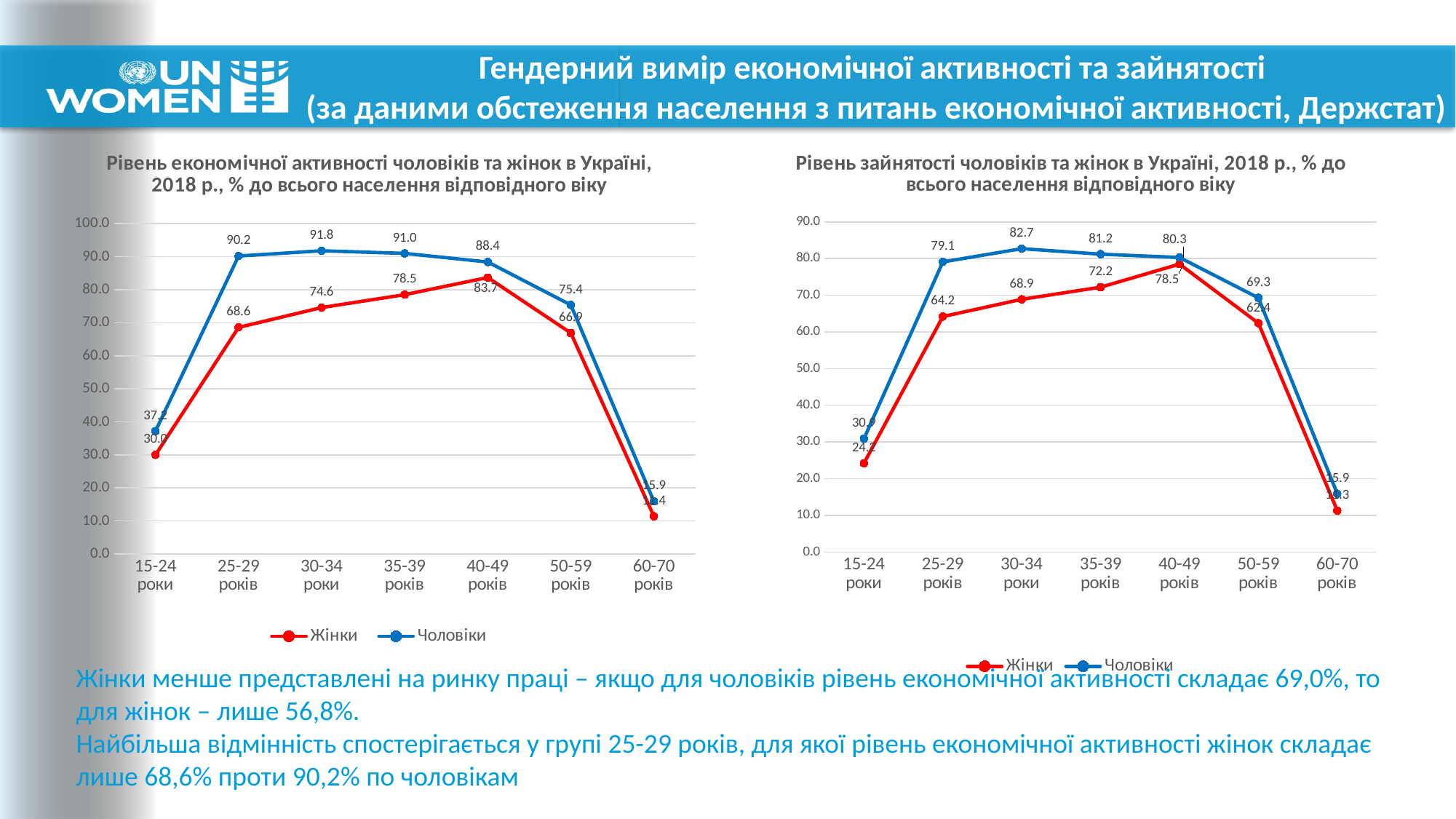
In the right chart (employment rate), which is larger in the 40-49 років age group: Чоловіки or Жінки? Чоловіки In the left chart (economic activity rate), what is the value for Чоловіки in the 25-29 років age group? 90.2 In the left chart (economic activity rate), is the value for Жінки in the 15-24 роки age group greater or less than 40.0? less In the right chart (employment rate), which age group has the lowest value for Жінки? 60-70 років How many series does the legend of the left chart (economic activity rate) list? 2 In the left chart (economic activity rate), which age group has the highest value for Чоловіки? 30-34 роки In the right chart (employment rate), what is the value for Жінки in the 25-29 років age group? 64.2 In the left chart (economic activity rate), what is the difference between Чоловіки and Жінки in the 25-29 років age group? 21.6 In the right chart (employment rate), what is the value for Чоловіки in the 30-34 роки age group? 82.7 In the left chart (economic activity rate), what is the value for Жінки in the 40-49 років age group? 83.7 What type of chart is the right chart (employment rate)? Line chart How many age groups are shown on the x axis of the right chart (employment rate)? 7